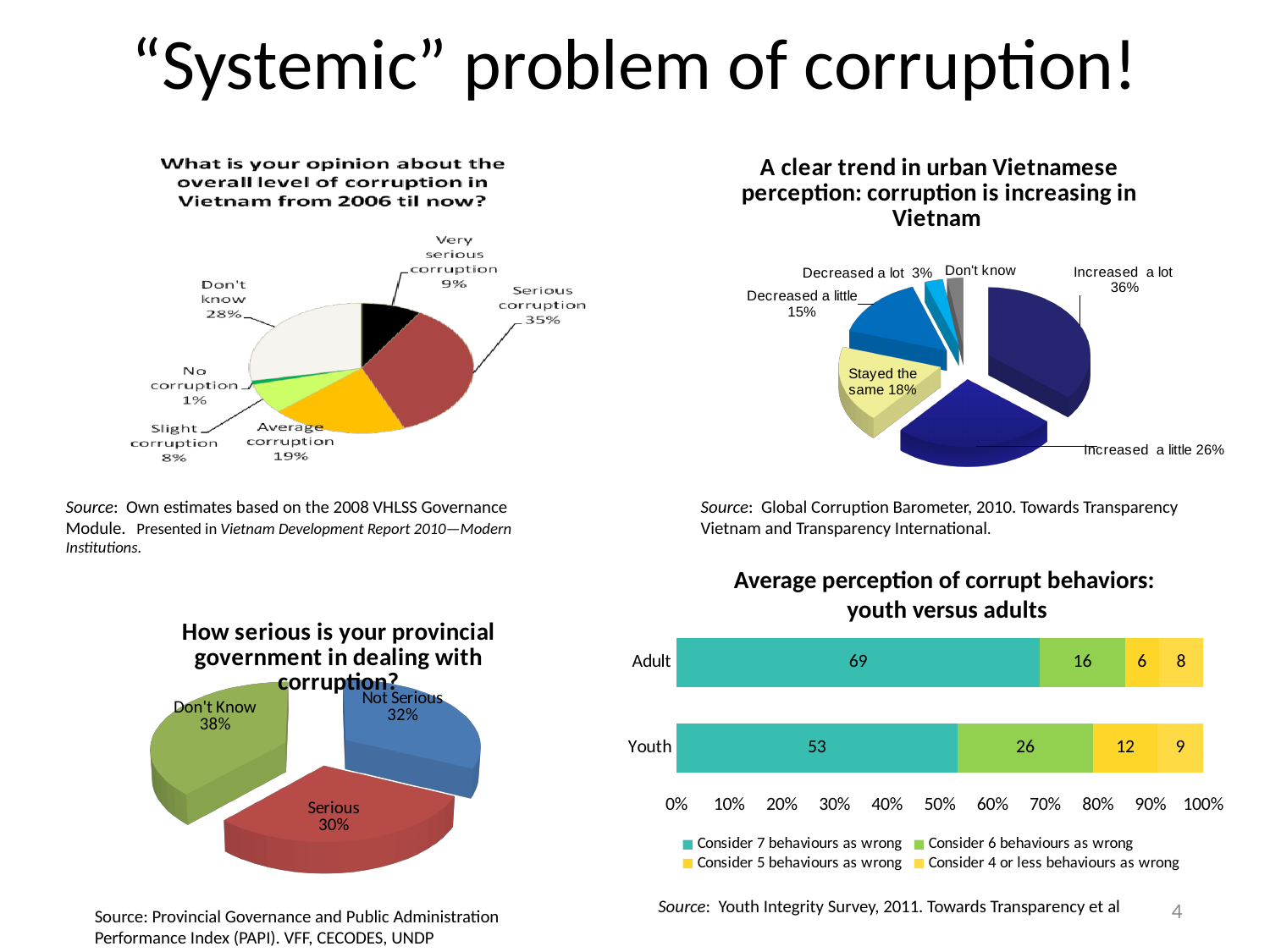
In the chart titled "A clear trend in urban Vietnamese perception: corruption is increasing in Vietnam", what kind of chart is used? Pie chart In the chart titled "A clear trend in urban Vietnamese perception: corruption is increasing in Vietnam", what is the difference between the "Increased a little" and "Decreased a little" shares? 11% In the chart titled "Average perception of corrupt behaviors: youth versus adults", what is the value for Youth in the "Consider 6 behaviours as wrong" series? 26 In the chart titled "How serious is your provincial government in dealing with corruption?", what share of respondents answered "Serious"? 30% In the chart titled "A clear trend in urban Vietnamese perception: corruption is increasing in Vietnam", what share of respondents said corruption "Increased a lot"? 36% In the chart titled "Average perception of corrupt behaviors: youth versus adults", which group has the larger value for "Consider 7 behaviours as wrong", Adult or Youth? Adult In the chart titled "What is your opinion about the overall level of corruption in Vietnam from 2006 til now?", which response has the smallest share? No corruption In the chart titled "What is your opinion about the overall level of corruption in Vietnam from 2006 til now?", what share of respondents answered "Serious corruption"? 35% In the chart titled "What is your opinion about the overall level of corruption in Vietnam from 2006 til now?", how many response categories are shown? 6 In the chart titled "How serious is your provincial government in dealing with corruption?", which response has the largest share? Don't Know In the chart titled "Average perception of corrupt behaviors: youth versus adults", how many series does the legend list? 4 In the chart titled "Average perception of corrupt behaviors: youth versus adults", what kind of chart is used? Stacked bar chart